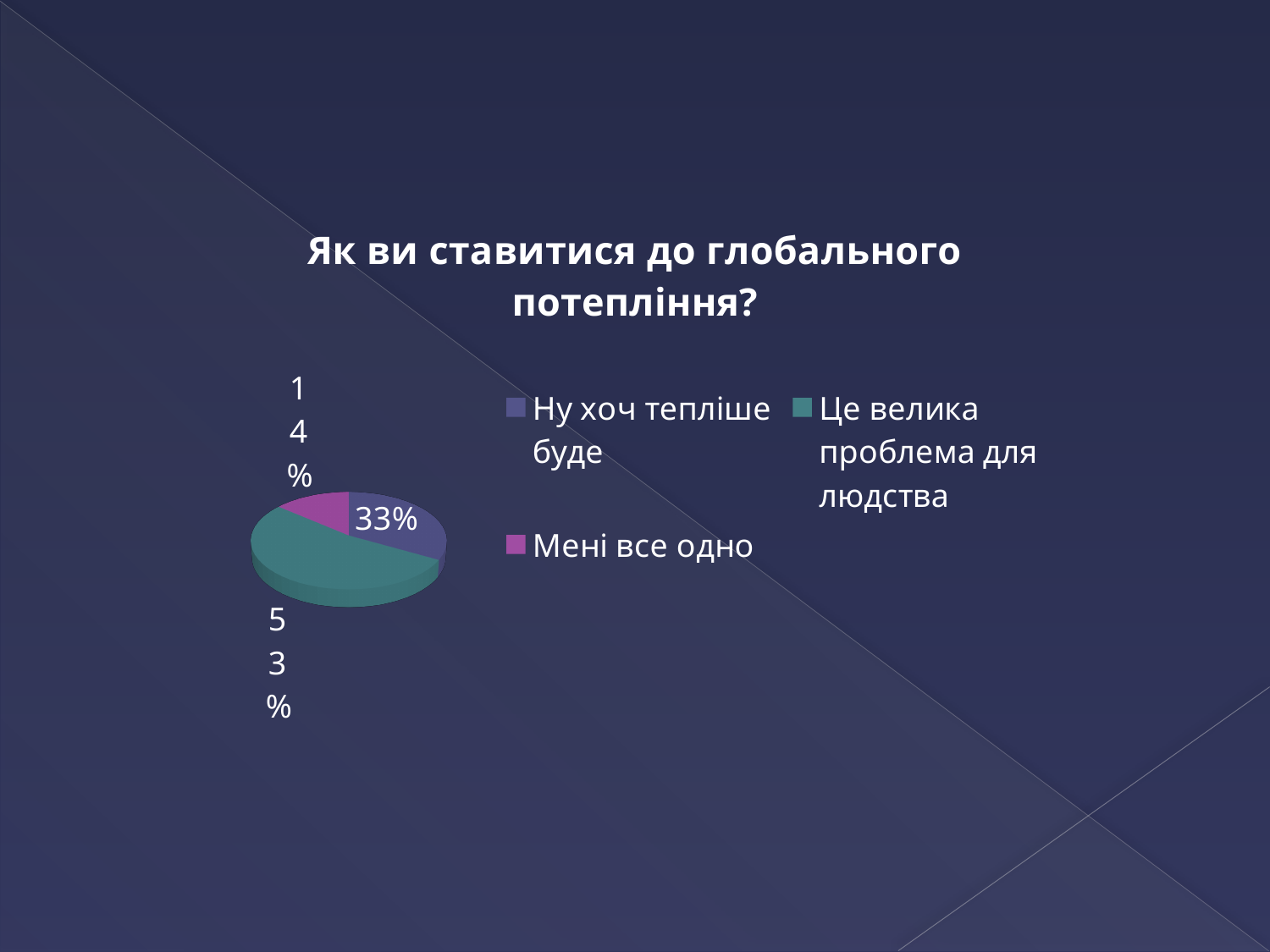
What share of the pie is labelled "Ну хоч тепліше буде"? 33% What share of the pie is labelled "Мені все одно"? 14% Which is larger: the share for "Ну хоч тепліше буде" or the share for "Мені все одно"? Ну хоч тепліше буде Which category has the largest share of the pie? Це велика проблема для людства What is the title of the chart? Як ви ставитися до глобального потепління? Which category has the smallest share of the pie? Мені все одно What is the difference in percentage points between "Ну хоч тепліше буде" and "Мені все одно"? 19 What is the difference in percentage points between "Це велика проблема для людства" and "Ну хоч тепліше буде"? 20 What type of chart is shown on the slide? pie chart What share of the pie is labelled "Це велика проблема для людства"? 53% Which legend entry is shown in magenta? Мені все одно How many slices does the pie chart have? 3